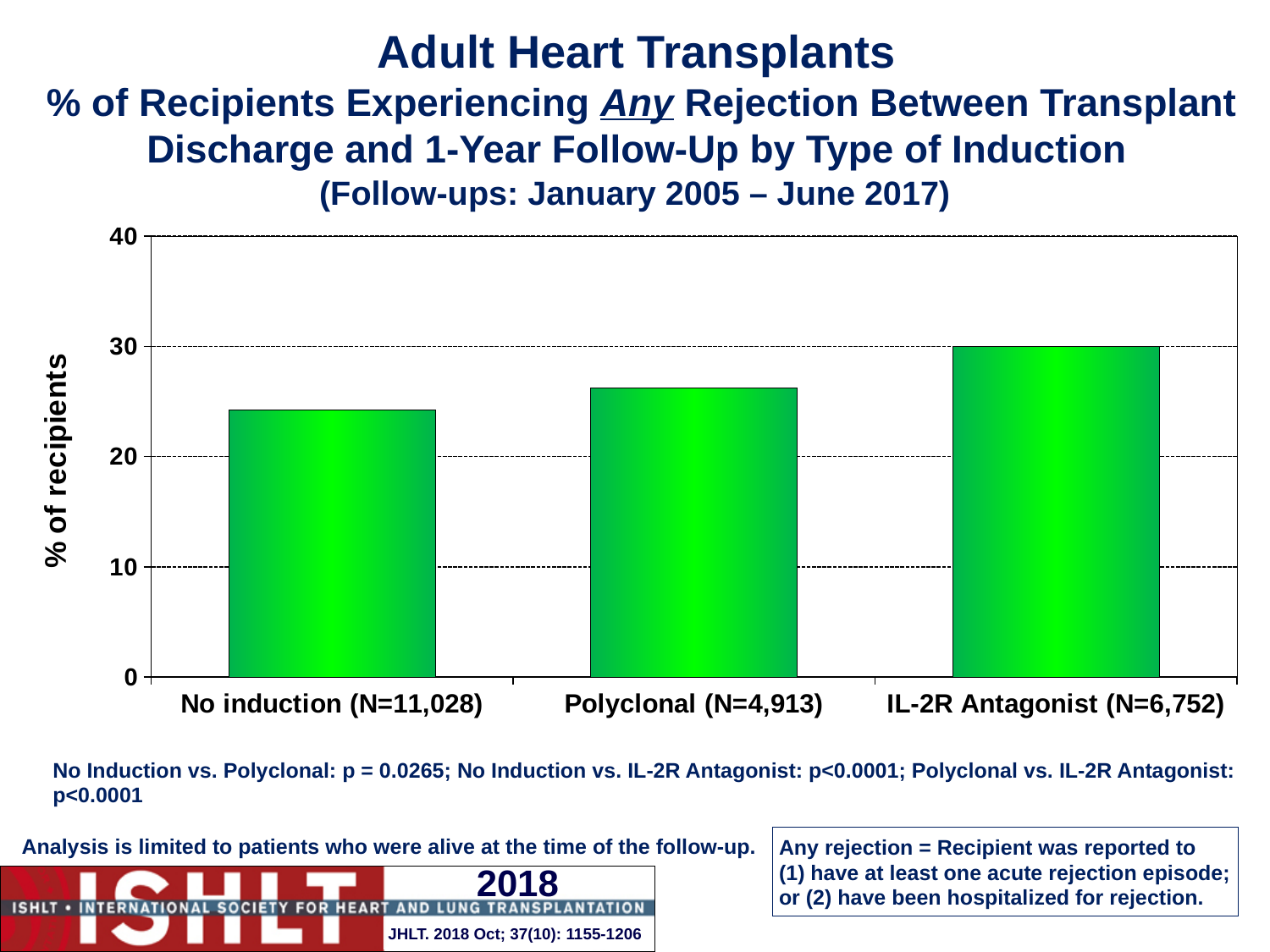
Which induction type has the highest percentage of recipients experiencing any rejection? IL-2R Antagonist (N=6,752) How many induction-type categories are plotted on the chart? 3 Is the value for No induction (N=11,028) greater or less than 30? less Is the value for No induction (N=11,028) greater or less than 20? greater Do the bar values rise or fall moving from left to right across the categories? rise Which has a higher percentage of recipients experiencing any rejection, Polyclonal or IL-2R Antagonist? IL-2R Antagonist Is the value for Polyclonal (N=4,913) greater or less than 30? less Which has a higher percentage of recipients experiencing any rejection, No induction or Polyclonal? Polyclonal What kind of chart is shown on the slide? bar chart What is the label on the vertical axis of the chart? % of recipients Which induction type has the lowest percentage of recipients experiencing any rejection? No induction (N=11,028)